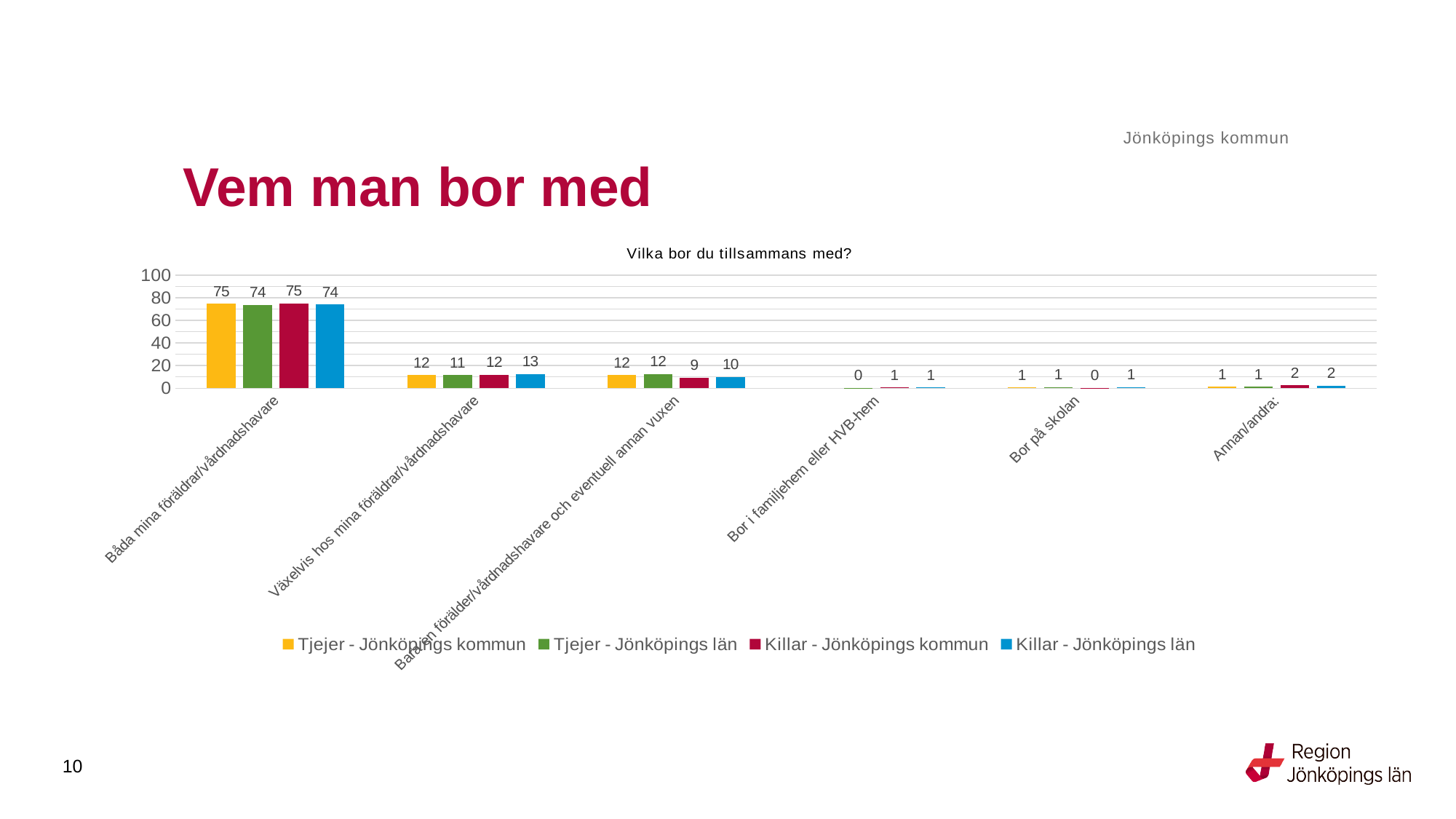
What is the value for Killar - Jönköpings kommun in the category 'Bor på skolan'? 0 In the category 'Växelvis hos mina föräldrar/vårdnadshavare', which is larger: Tjejer - Jönköpings län or Killar - Jönköpings län? Killar - Jönköpings län What is the value for Killar - Jönköpings kommun in the category 'Bara en förälder/vårdnadshavare och eventuell annan vuxen'? 9 What is the value for Killar - Jönköpings län in the category 'Växelvis hos mina föräldrar/vårdnadshavare'? 13 What is the title of the chart? Vilka bor du tillsammans med? Which category has the highest values across all series? Båda mina föräldrar/vårdnadshavare What is the value for Tjejer - Jönköpings kommun in the category 'Båda mina föräldrar/vårdnadshavare'? 75 Which colour represents Killar - Jönköpings kommun in the legend? Red What kind of chart is shown on the slide? Bar chart What is the difference between Tjejer - Jönköpings kommun and Killar - Jönköpings kommun in the category 'Bara en förälder/vårdnadshavare och eventuell annan vuxen'? 3 How many series does the legend list? 4 How many categories are shown on the x axis? 6